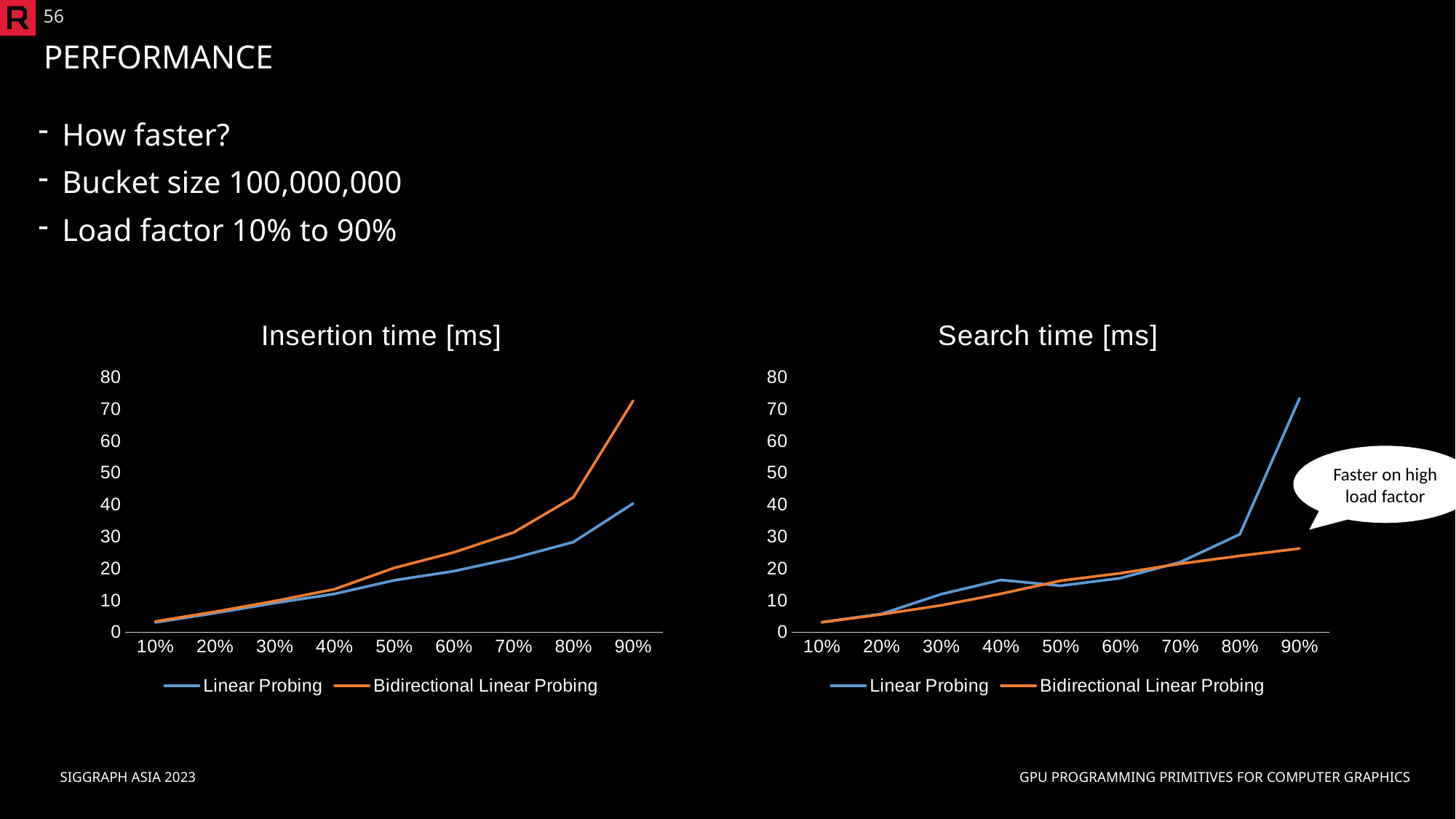
In the Search time [ms] chart, is the Linear Probing value at 90% greater or less than 60? greater In the Search time [ms] chart, is the Bidirectional Linear Probing value at 90% greater or less than 40? less In the Insertion time [ms] chart, do the Bidirectional Linear Probing values rise or fall as the load factor increases? rise In the Search time [ms] chart, which series has the higher value at 90% load factor? Linear Probing In the Insertion time [ms] chart, is the Linear Probing value at 90% greater or less than 50? less In the Insertion time [ms] chart, which series has the higher value at 90% load factor? Bidirectional Linear Probing In the Search time [ms] chart, at which load factor does Linear Probing reach its highest value? 90% How many series does the legend of the Search time [ms] chart list? 2 What is the title of the chart on the right side of the slide? Search time [ms] What kind of chart is the Insertion time [ms] chart? line chart How many load factor values are plotted along the x axis of the Insertion time [ms] chart? 9